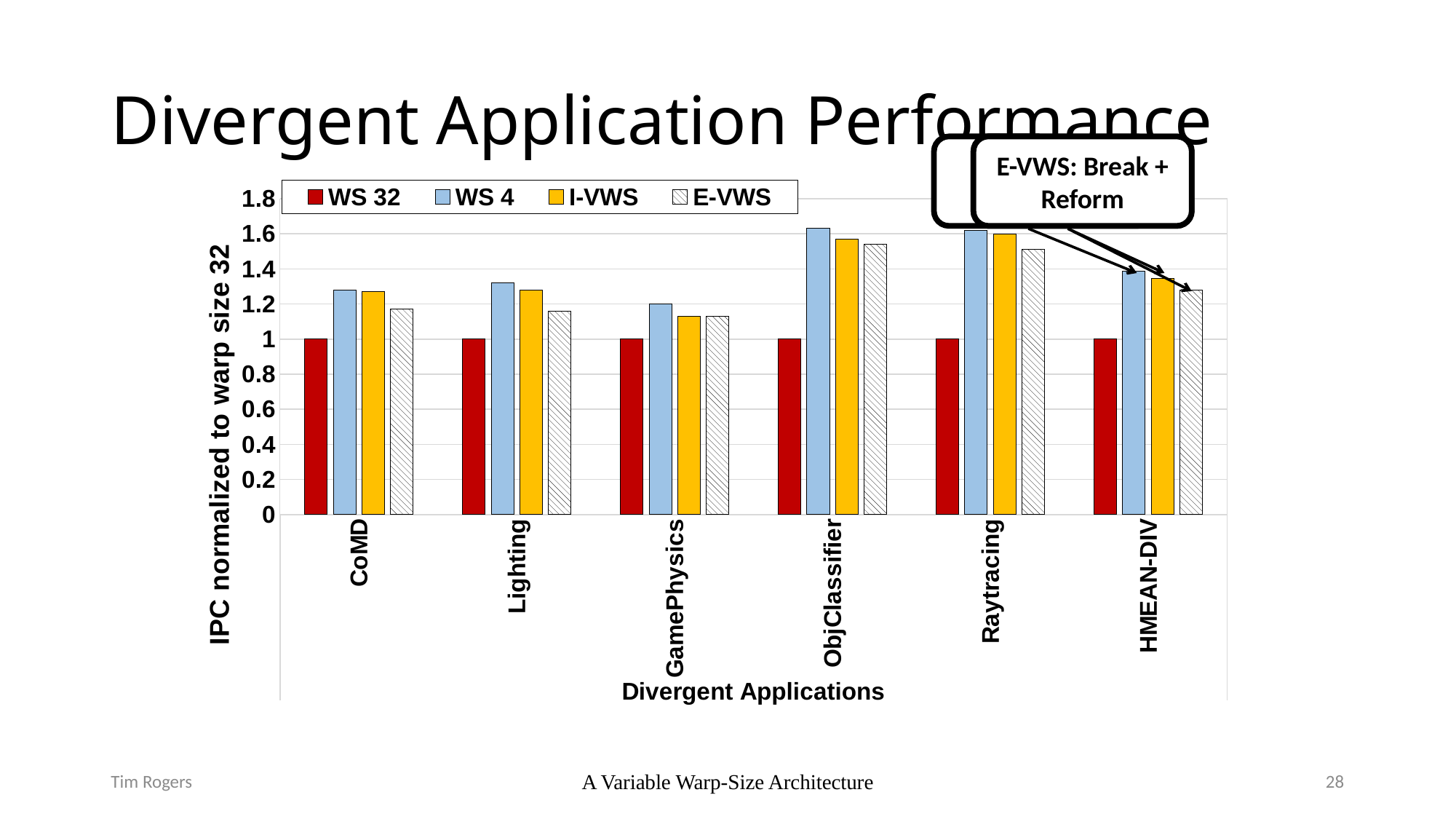
What is the WS 32 value for CoMD? 1 What is the WS 32 value for Raytracing? 1 Is the WS 4 value for Lighting greater or less than 1.2? greater For CoMD, which is larger: the WS 4 value or the E-VWS value? WS 4 What kind of chart is shown on the slide? bar chart How many applications are shown along the x axis? 6 Is the E-VWS value for Raytracing greater or less than 1.4? greater What is the title of the y axis? IPC normalized to warp size 32 Is the WS 4 value for ObjClassifier greater or less than 1.4? greater Which application has the lowest WS 4 value? GamePhysics How many series does the legend list? 4